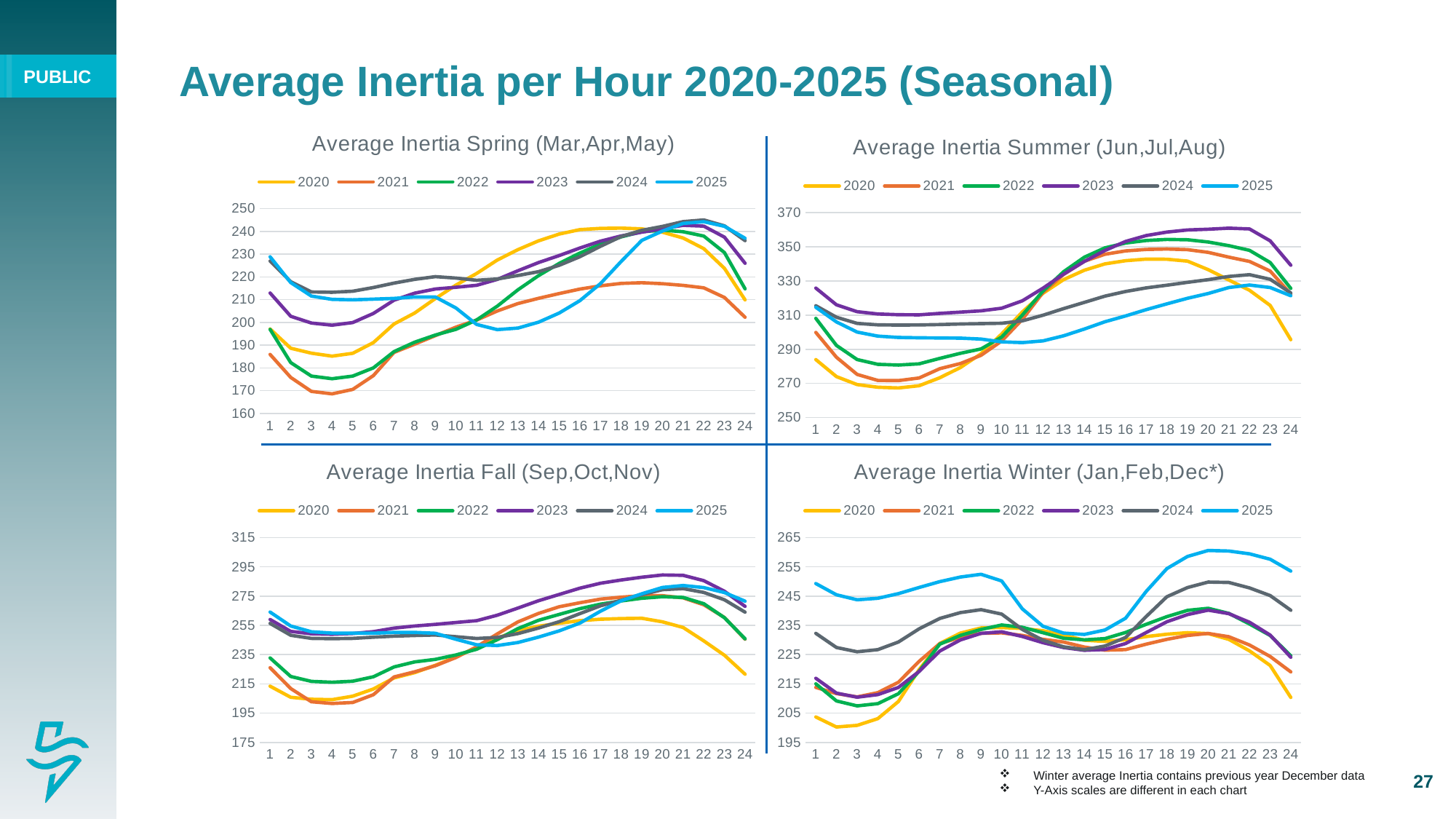
In the Average Inertia Spring (Mar,Apr,May) chart, is the value for 2021 at hour 4 greater or less than 180? less In the Average Inertia Summer (Jun,Jul,Aug) chart, which series is larger at hour 1, 2023 or 2020? 2023 In the Average Inertia Summer (Jun,Jul,Aug) chart, is the value for 2023 at hour 21 greater or less than 350? greater What kind of chart is the Average Inertia Spring (Mar,Apr,May) chart? line chart How many series does the legend of the Average Inertia Summer (Jun,Jul,Aug) chart list? 6 In the Average Inertia Fall (Sep,Oct,Nov) chart, is the value for 2020 at hour 24 greater or less than 235? less In the Average Inertia Winter (Jan,Feb,Dec*) chart, which series reaches the highest value? 2025 What is the title of the bottom-right chart on the slide? Average Inertia Winter (Jan,Feb,Dec*) In the Average Inertia Winter (Jan,Feb,Dec*) chart, which series is larger at hour 1, 2025 or 2020? 2025 In the Average Inertia Summer (Jun,Jul,Aug) chart, does the 2020 series rise or fall from hour 18 to hour 24? fall How many hours are shown on the x axis of the Average Inertia Fall (Sep,Oct,Nov) chart? 24